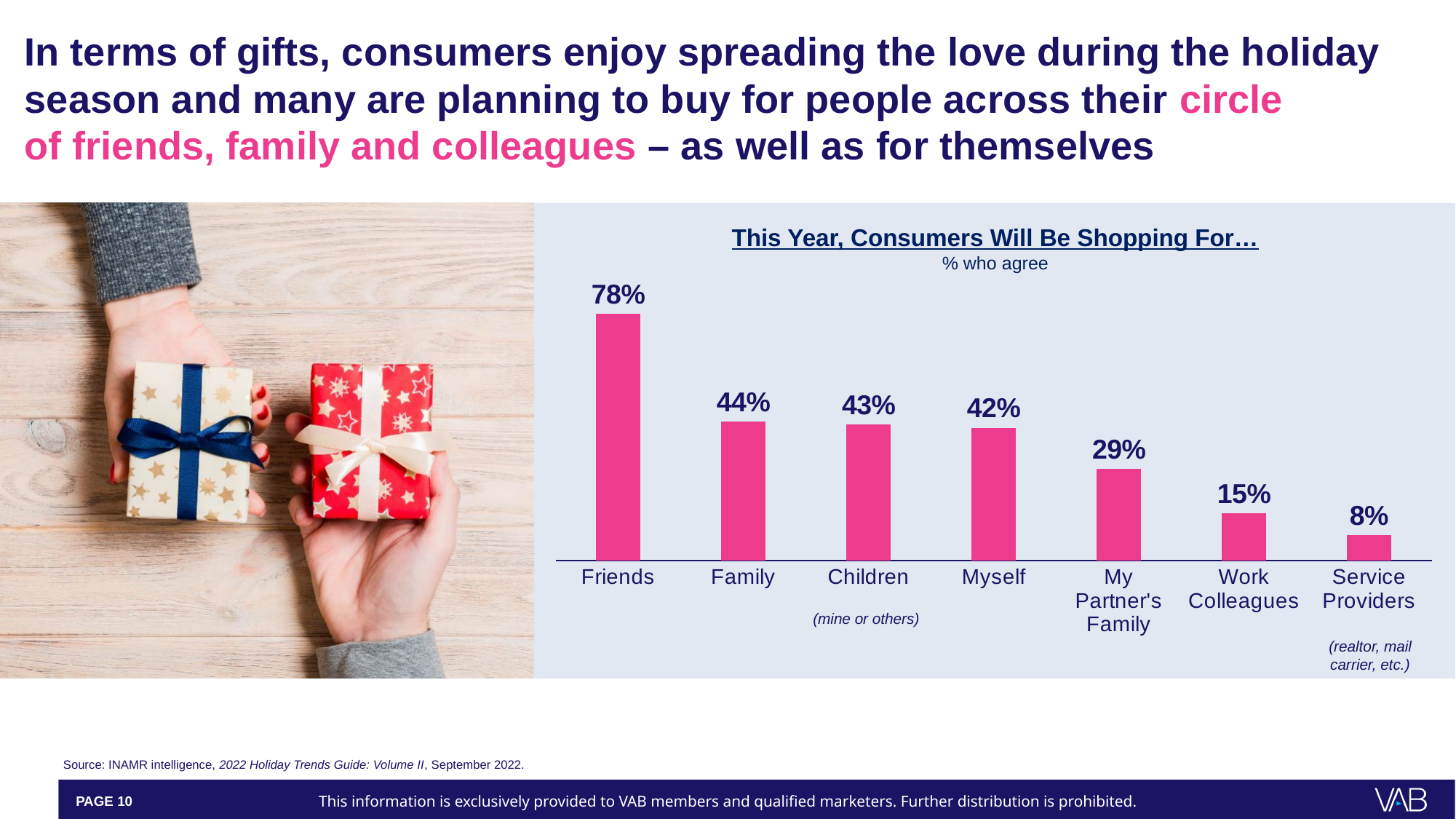
Do the values rise or fall moving from left to right across the categories? Fall Which is larger, the value for Myself or the value for My Partner's Family? Myself Which category has the highest percentage of consumers who agree? Friends What percentage of consumers say they will be shopping for Work Colleagues? 15% What is the difference in percentage points between Work Colleagues and Service Providers? 7 What percentage of consumers say they will be shopping for My Partner's Family? 29% What kind of chart is shown on the slide? Bar chart What is the title of the chart? This Year, Consumers Will Be Shopping For… What percentage of consumers say they will be shopping for Friends? 78% What is the difference in percentage points between Friends and Family? 34 Which category has the lowest percentage of consumers who agree? Service Providers How many categories are shown in the chart? 7